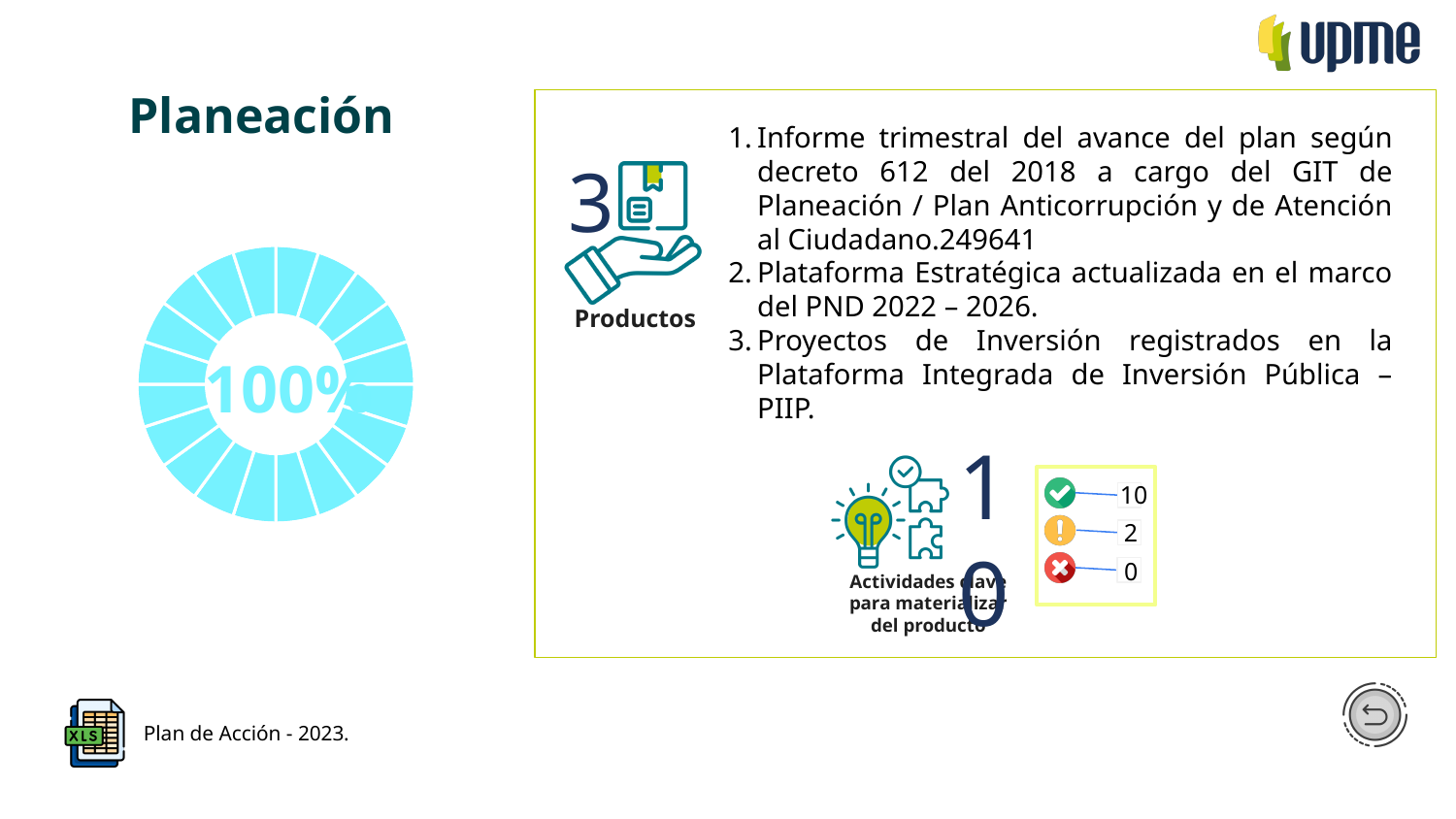
In the status box, what is the total of the three numbers shown? 12 What colour is the ring of the doughnut chart on the left of the slide? light blue (cyan) Is the value shown in the doughnut chart greater or less than 50%? greater What kind of chart is shown on the left side of the slide under the title "Planeación"? doughnut chart In the status box, what is the difference between the number beside the green check icon and the number beside the yellow exclamation icon? 8 In the status box, which icon has the lowest number: the green check, the yellow exclamation, or the red X? red X How many status categories (icons with numbers) are shown in the status box? 3 In the status box next to "Actividades clave para materializar el producto", what number is shown beside the green check icon? 10 In the status box next to "Actividades clave para materializar el producto", what number is shown beside the yellow exclamation icon? 2 In the status box next to "Actividades clave para materializar el producto", what number is shown beside the red X icon? 0 What percentage is displayed in the centre of the doughnut chart on the left? 100% In the status box, which icon has the highest number: the green check, the yellow exclamation, or the red X? green check